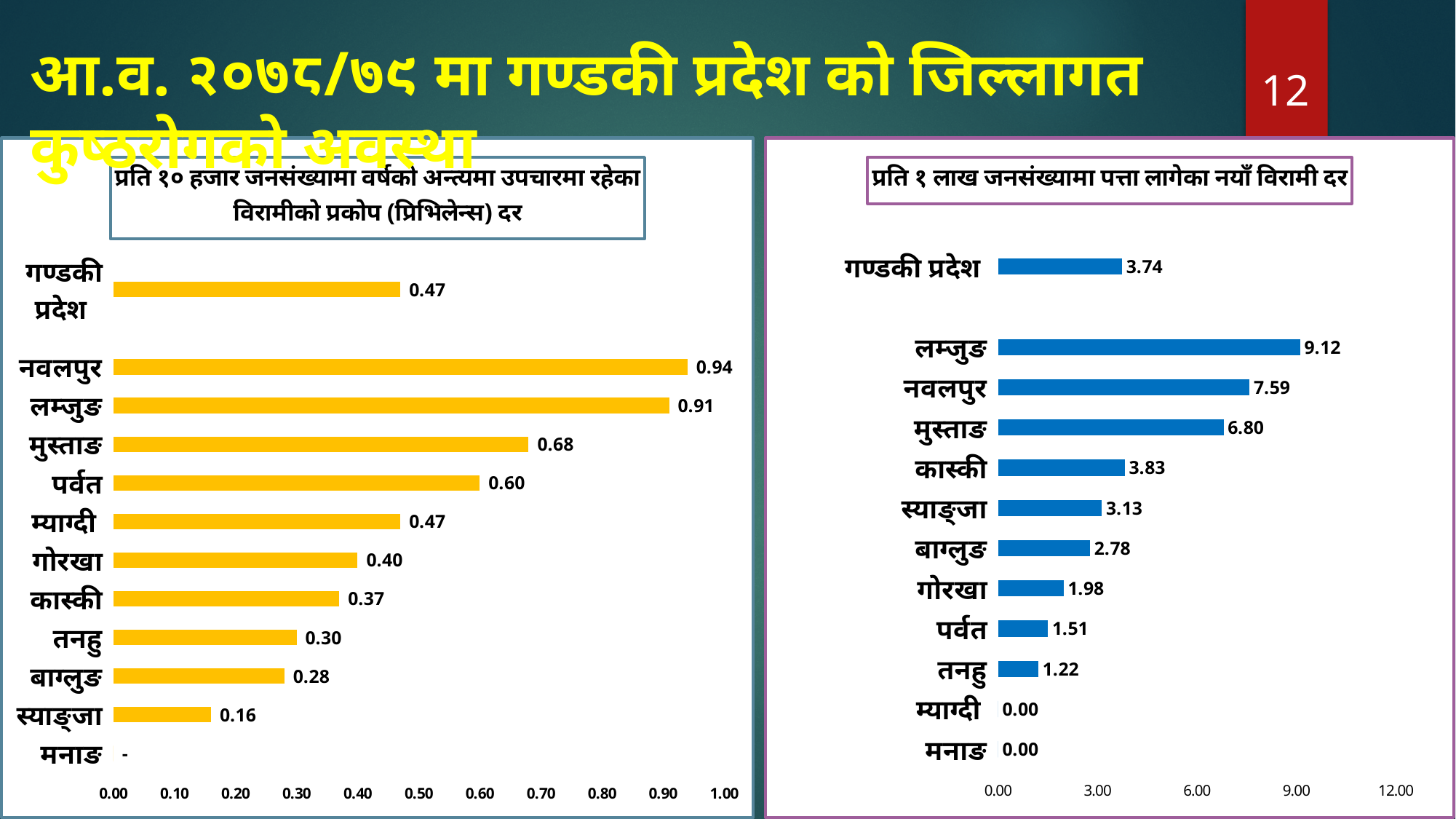
In the left chart (prevalence rate per 10,000 population), what is the value for गण्डकी प्रदेश? 0.47 In the right chart (new case detection rate per 100,000 population), what is the value for लम्जुङ? 9.12 In the left chart (prevalence rate per 10,000 population), which is larger, the value for मुस्ताङ or the value for पर्वत? मुस्ताङ In the right chart (new case detection rate per 100,000 population), which district has the highest value? लम्जुङ What type of chart is the right chart (new case detection rate per 100,000 population)? Bar chart In the left chart (prevalence rate per 10,000 population), which district has the highest value? नवलपुर In the left chart (prevalence rate per 10,000 population), what is the value for स्याङ्जा? 0.16 In the right chart (new case detection rate per 100,000 population), what is the value for गण्डकी प्रदेश? 3.74 In the right chart (new case detection rate per 100,000 population), how many categories are shown on the vertical axis? 12 In the left chart (prevalence rate per 10,000 population), what is the difference between the values for नवलपुर and लम्जुङ? 0.03 In the left chart (prevalence rate per 10,000 population), what is the value for नवलपुर? 0.94 In the right chart (new case detection rate per 100,000 population), what is the difference between the values for नवलपुर and मुस्ताङ? 0.79